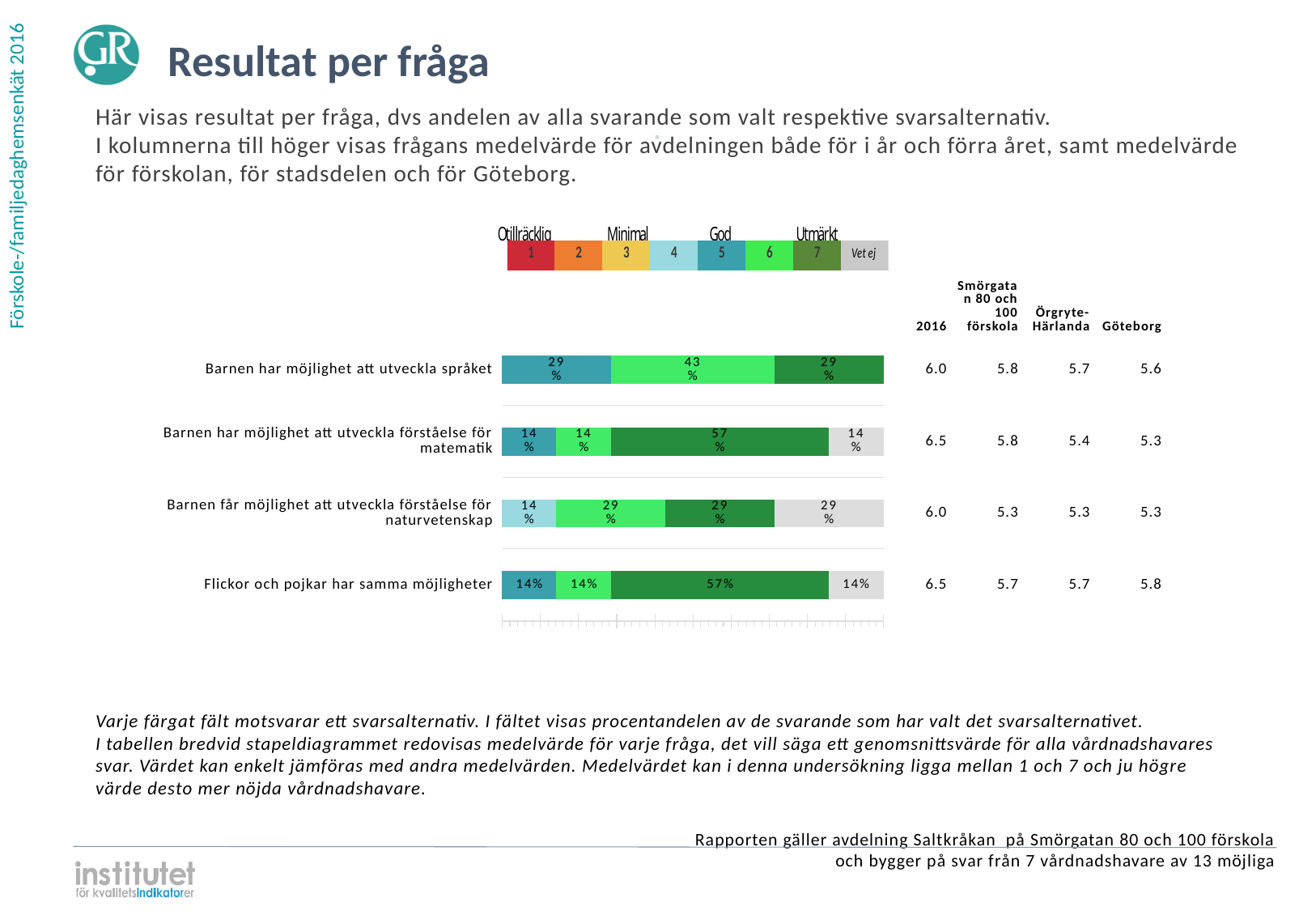
What is the Göteborg mean value for 'Flickor och pojkar har samma möjligheter'? 5.8 What percentage chose option 7 (dark green) for 'Barnen har möjlighet att utveckla förståelse för matematik'? 57% What percentage of respondents chose option 6 for 'Barnen har möjlighet att utveckla språket'? 43% How many questions (categories) are shown in the bar chart? 4 How many response options does the legend above the chart list? 8 What is the 2016 mean value for 'Barnen har möjlighet att utveckla förståelse för matematik' in the table next to the chart? 6.5 Is the option 6 share larger for 'Barnen har möjlighet att utveckla språket' or for 'Barnen får möjlighet att utveckla förståelse för naturvetenskap'? Barnen har möjlighet att utveckla språket For 'Flickor och pojkar har samma möjligheter', what is the difference between the option 7 share and the 'Vet ej' share? 43 percentage points What kind of chart is used to show the results per question? Stacked bar chart What percentage chose option 4 (light blue) for 'Barnen får möjlighet att utveckla förståelse för naturvetenskap'? 14% What percentage answered 'Vet ej' for 'Barnen får möjlighet att utveckla förståelse för naturvetenskap'? 29% Which question has the largest share of respondents choosing option 6 (light green)? Barnen har möjlighet att utveckla språket